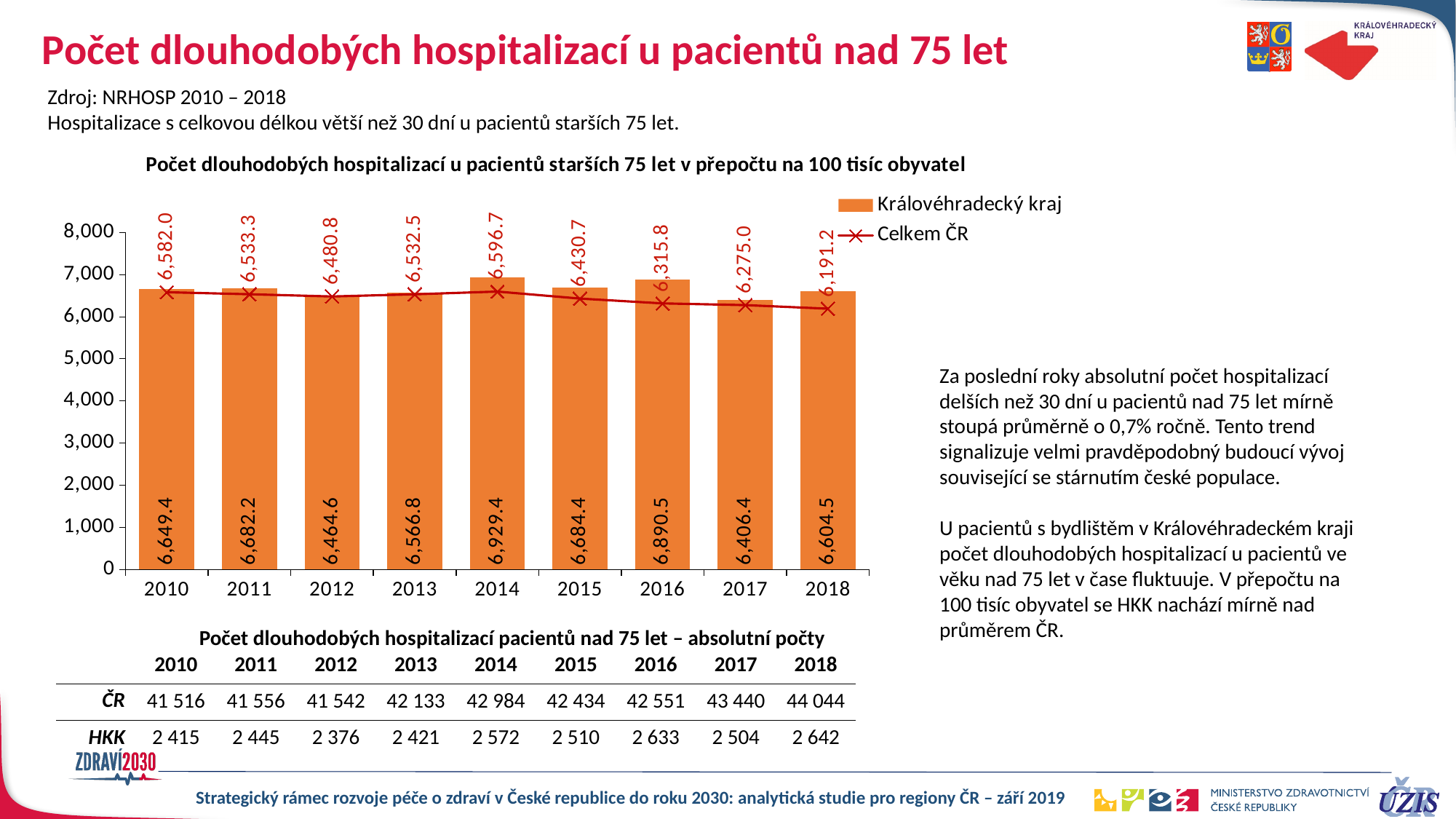
What kind of chart is used for the Královéhradecký kraj series? bar chart In which year is the Královéhradecký kraj value highest? 2014 What is the value for Královéhradecký kraj in 2014? 6,929.4 In which year is the Celkem ČR value lowest? 2018 In which year is the Královéhradecký kraj value lowest? 2017 Does the Celkem ČR series rise or fall overall from 2010 to 2018? fall What is the value for Celkem ČR in 2018? 6,191.2 Which is larger in 2016: the Královéhradecký kraj value or the Celkem ČR value? Královéhradecký kraj How many series does the chart legend list? 2 What is the difference between the Královéhradecký kraj value and the Celkem ČR value in 2018? 413.3 How many years are shown on the x axis of the chart? 9 What is the value for Královéhradecký kraj in 2010? 6,649.4